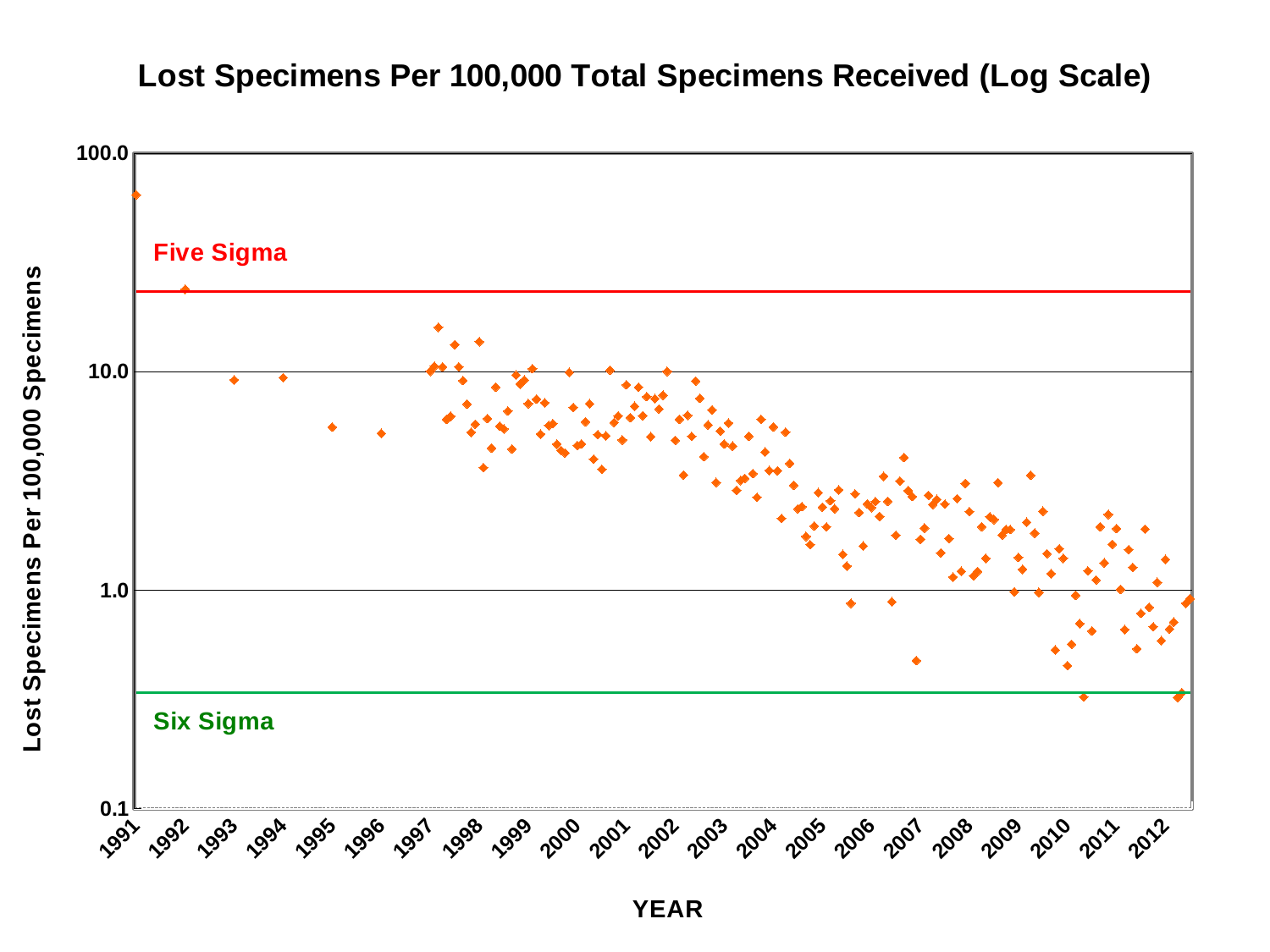
What is the highest value shown on the y axis? 100.0 Is the value plotted for 1992 greater or less than 10.0? greater Is the value plotted for 1991 greater or less than the value plotted for 1992? greater Is the value plotted for 1995 greater or less than 10.0? less Do the plotted values generally rise or fall from 1991 to 2012? fall What is the title of the chart? Lost Specimens Per 100,000 Total Specimens Received (Log Scale) Is the value plotted for 1996 greater or less than 10.0? less Which year has the highest plotted value? 1991 What kind of chart is shown on the slide? scatter chart What is the label of the x axis? YEAR How many year labels are shown on the x axis? 22